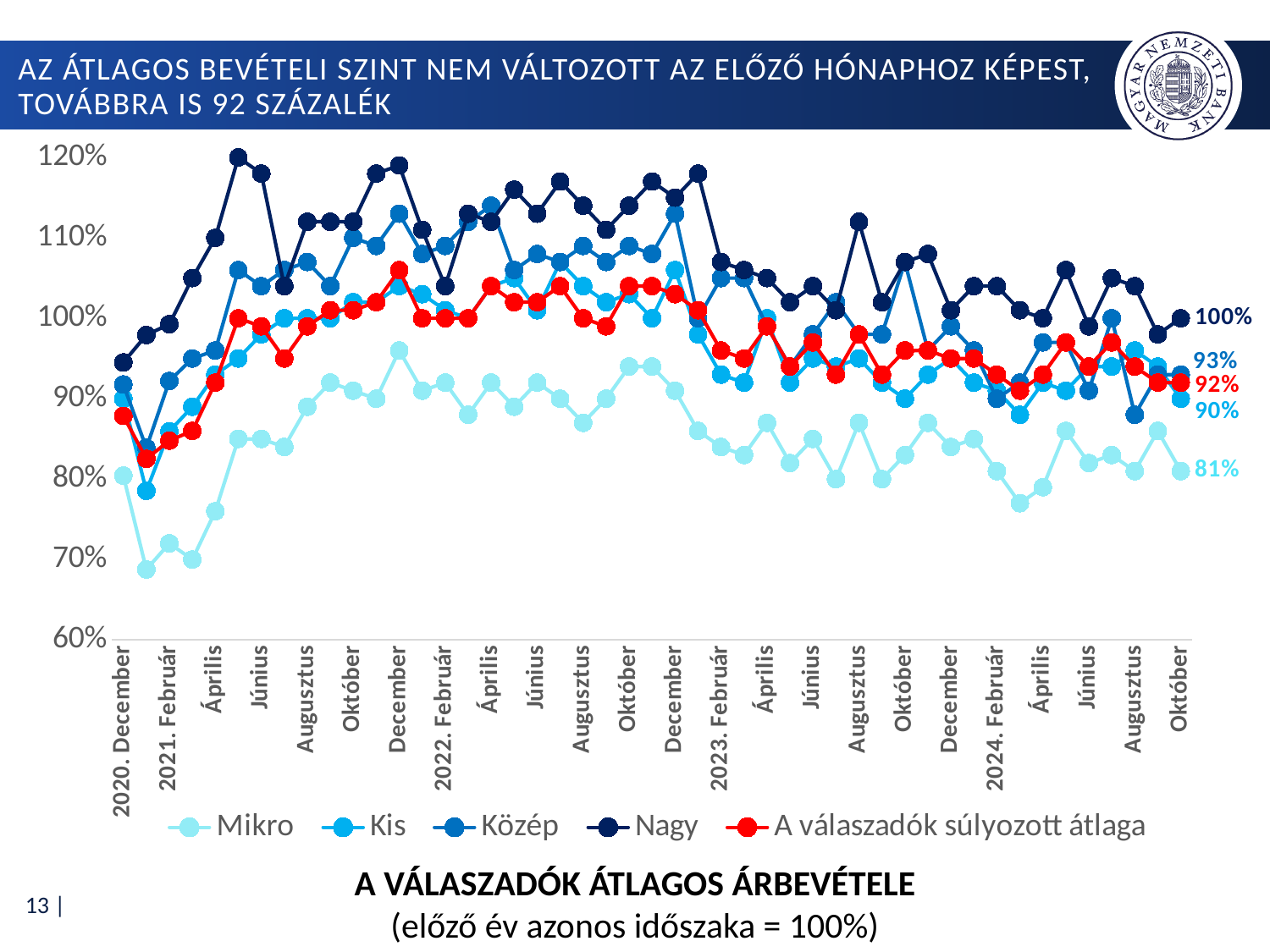
What is the value of the Közép series at the last point (2024 Október)? 93% What is the value of the Kis series at the last point (2024 Október)? 90% How many series does the legend list? 5 Is the value for Mikro in 2021 Február greater or less than 80%? less What is the value of the Nagy series at the last point (2024 Október)? 100% Which series has the lowest value at the last point (2024 Október)? Mikro Which series has the highest value at the last point (2024 Október)? Nagy What is the value of 'A válaszadók súlyozott átlaga' at the last point (2024 Október)? 92% What kind of chart is shown on the slide? Line chart What is the value of the Mikro series at the last point (2024 Október)? 81% What is the difference between the Nagy and Mikro values at the last point (2024 Október)? 19 percentage points